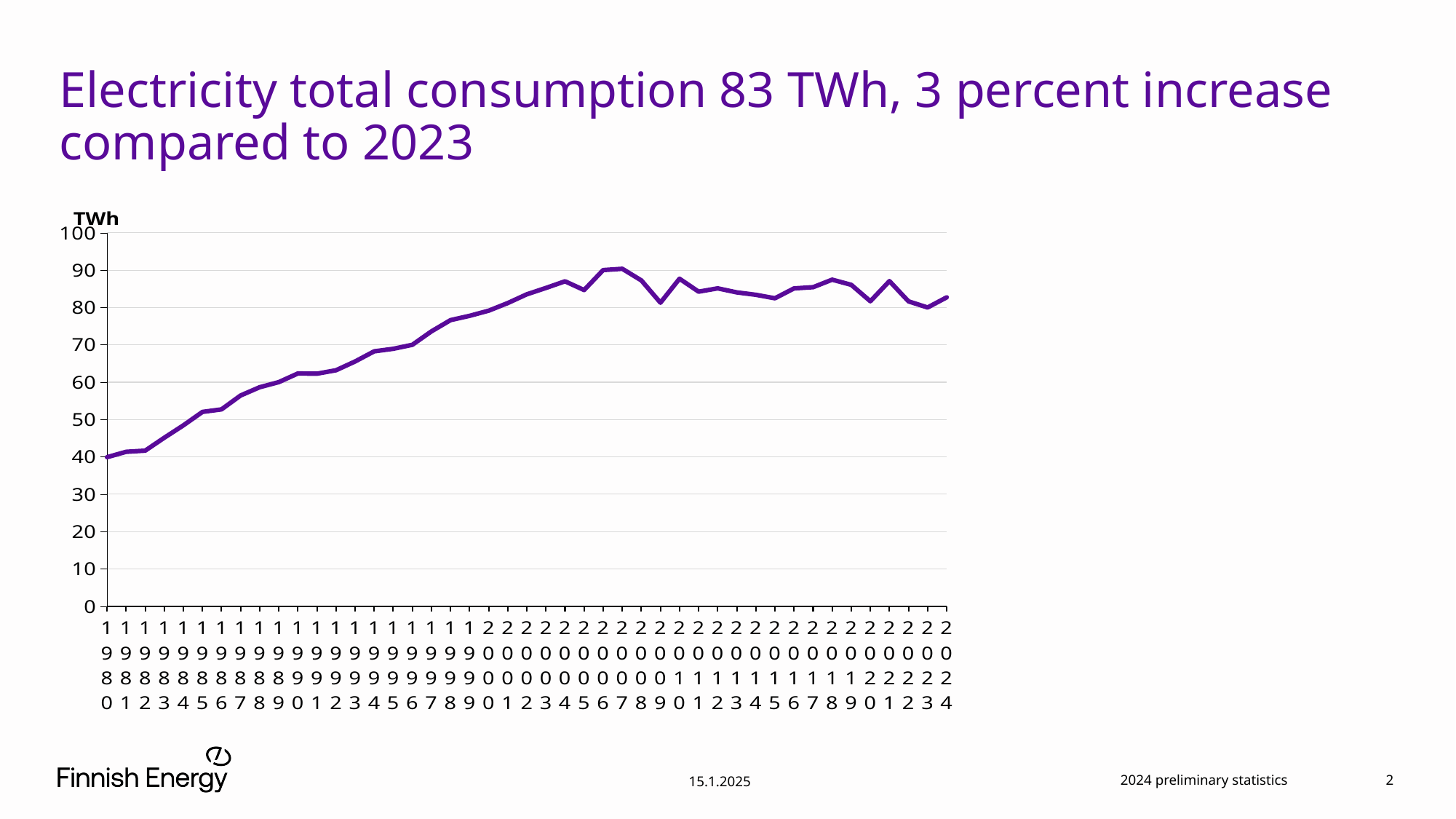
What kind of chart is shown on the slide? line chart What unit is shown on the vertical axis of the chart? TWh Is the value for 1990 greater or less than 60? greater Which is larger, the value for 1990 or the value for 2010? 2010 Is the value for 2007 greater or less than 80? greater Which year has the lowest electricity consumption on the chart? 1980 According to the slide title, what was total electricity consumption in 2024? 83 TWh Does electricity consumption rise or fall from 1980 to 2007? rise What is the first year shown on the x axis? 1980 Is the value for 1985 greater or less than 50? greater How many years (data points) are plotted on the chart? 45